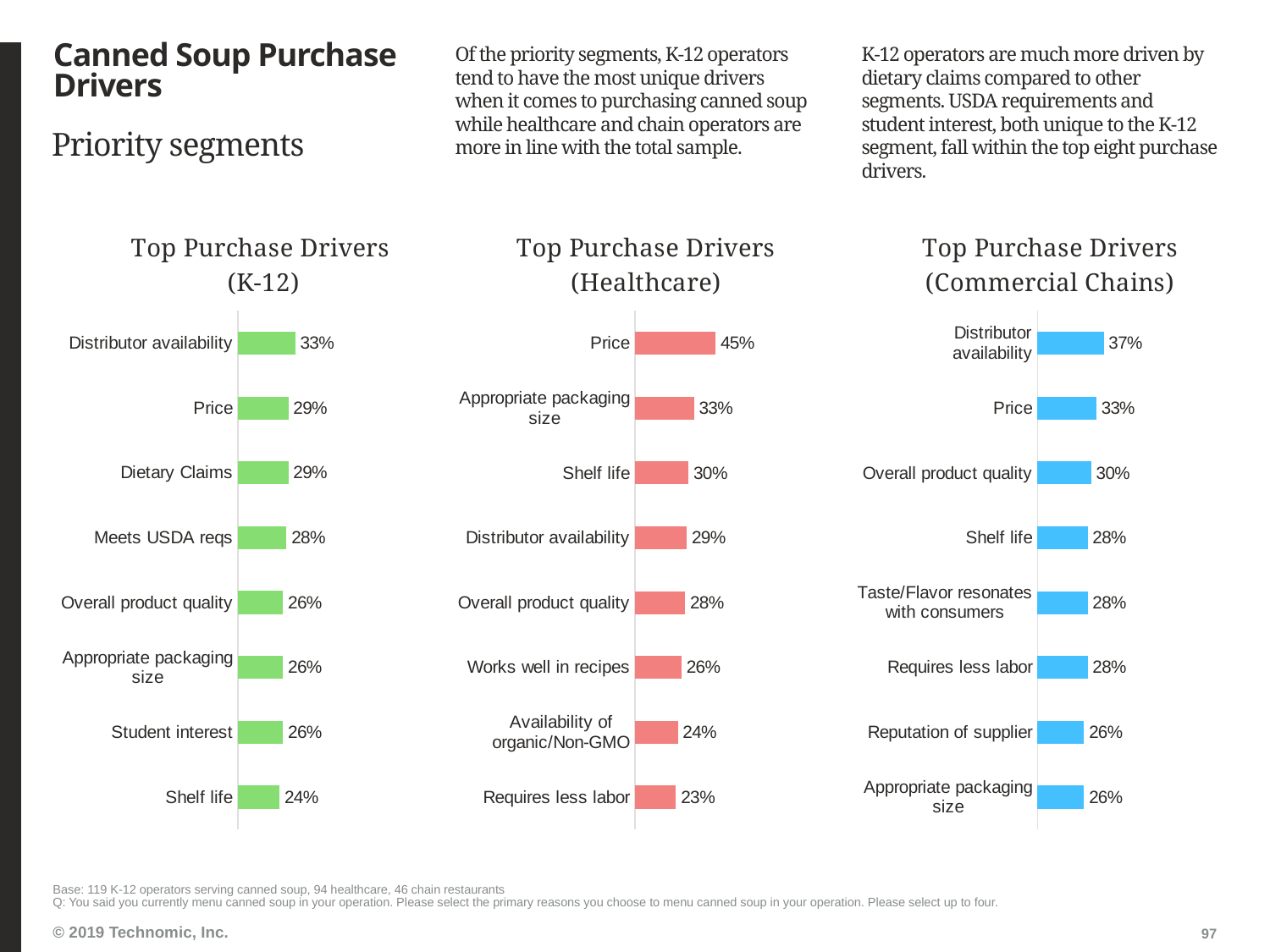
In the Top Purchase Drivers (Healthcare) chart, which category has the highest value? Price In the Top Purchase Drivers (K-12) chart, what is the value for Distributor availability? 33% In the Top Purchase Drivers (Commercial Chains) chart, what is the difference between Distributor availability and Price? 4% In the Top Purchase Drivers (K-12) chart, which is larger: Meets USDA reqs or Student interest? Meets USDA reqs In the Top Purchase Drivers (Commercial Chains) chart, what is the value for Reputation of supplier? 26% In the Top Purchase Drivers (Healthcare) chart, what is the value for Shelf life? 30% What colour are the bars in the Top Purchase Drivers (K-12) chart? Green How many categories are shown in the Top Purchase Drivers (Commercial Chains) chart? 8 In the Top Purchase Drivers (K-12) chart, which category has the lowest value? Shelf life In the Top Purchase Drivers (Healthcare) chart, do the values rise or fall from the top category to the bottom category? Fall What kind of chart is the Top Purchase Drivers (Healthcare) chart? Bar chart In the Top Purchase Drivers (Healthcare) chart, what is the difference between Price and Requires less labor? 22%